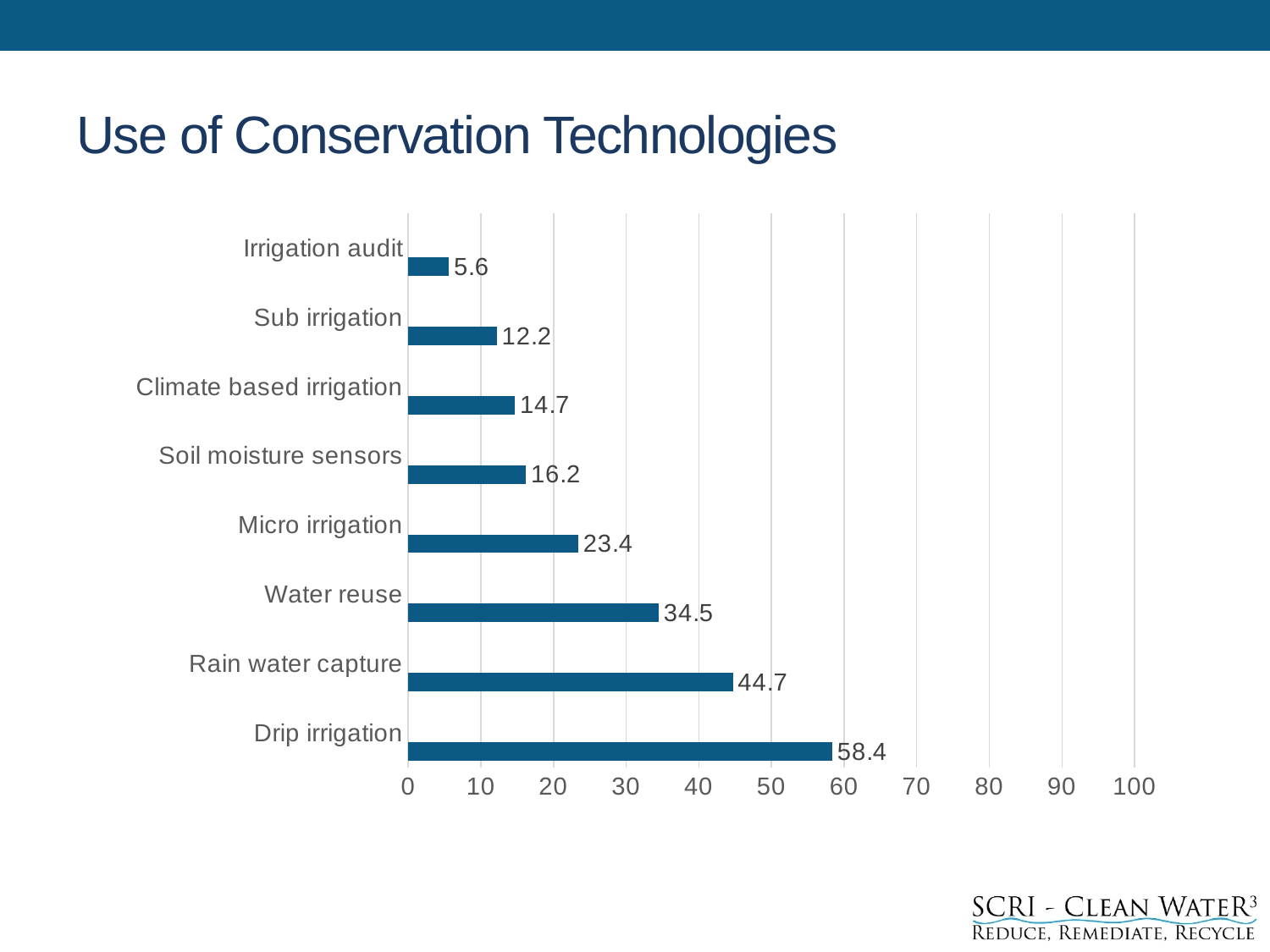
How many categories are shown in the chart? 8 What is the difference between the values for Micro irrigation and Sub irrigation? 11.2 What is the value for Water reuse? 34.5 What is the value for Soil moisture sensors? 16.2 What is the value for Drip irrigation? 58.4 Which category has the highest value? Drip irrigation What is the difference between the values for Drip irrigation and Rain water capture? 13.7 Which category has the lowest value? Irrigation audit What kind of chart is shown on the slide? Bar chart Which is larger, the value for Climate based irrigation or the value for Soil moisture sensors? Soil moisture sensors What is the title of the slide containing the chart? Use of Conservation Technologies Is the value for Rain water capture greater or less than 40? greater